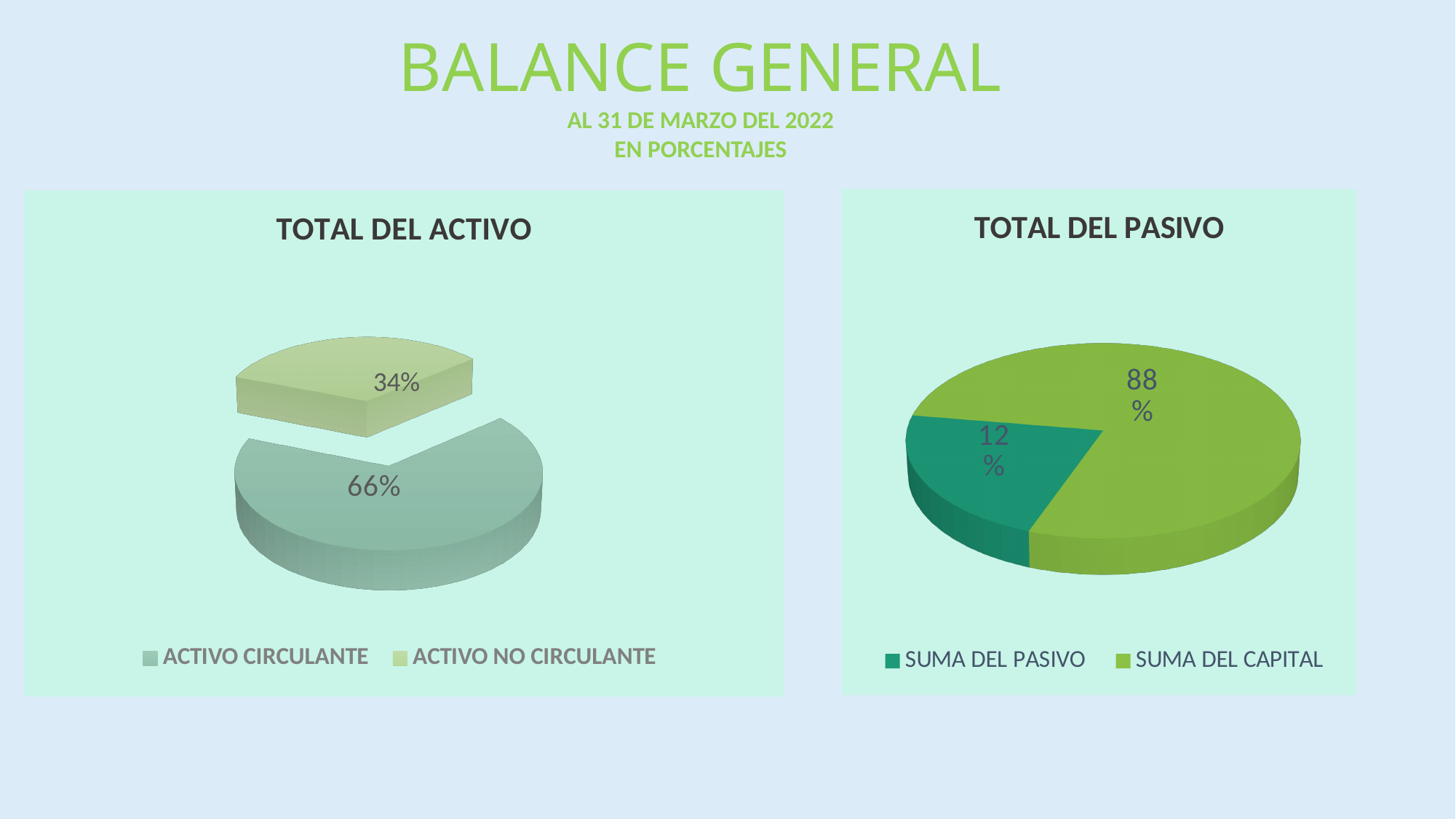
In the 'TOTAL DEL ACTIVO' chart, what is the difference in percentage points between ACTIVO CIRCULANTE and ACTIVO NO CIRCULANTE? 32 In the 'TOTAL DEL PASIVO' chart, which category has the smallest slice? SUMA DEL PASIVO How many slices does the 'TOTAL DEL PASIVO' chart have? 2 In the 'TOTAL DEL ACTIVO' chart, which category has the largest slice? ACTIVO CIRCULANTE In the 'TOTAL DEL PASIVO' chart, what percentage is shown for SUMA DEL CAPITAL? 88% What type of chart is the 'TOTAL DEL ACTIVO' chart? Pie chart What are the legend entries of the 'TOTAL DEL PASIVO' chart? SUMA DEL PASIVO, SUMA DEL CAPITAL In the 'TOTAL DEL PASIVO' chart, what is the difference in percentage points between SUMA DEL CAPITAL and SUMA DEL PASIVO? 76 Which is larger: SUMA DEL PASIVO in the 'TOTAL DEL PASIVO' chart or ACTIVO NO CIRCULANTE in the 'TOTAL DEL ACTIVO' chart? ACTIVO NO CIRCULANTE In the 'TOTAL DEL ACTIVO' chart, what percentage is shown for ACTIVO CIRCULANTE? 66% In the 'TOTAL DEL ACTIVO' chart, what percentage is shown for ACTIVO NO CIRCULANTE? 34% In the 'TOTAL DEL PASIVO' chart, what percentage is shown for SUMA DEL PASIVO? 12%